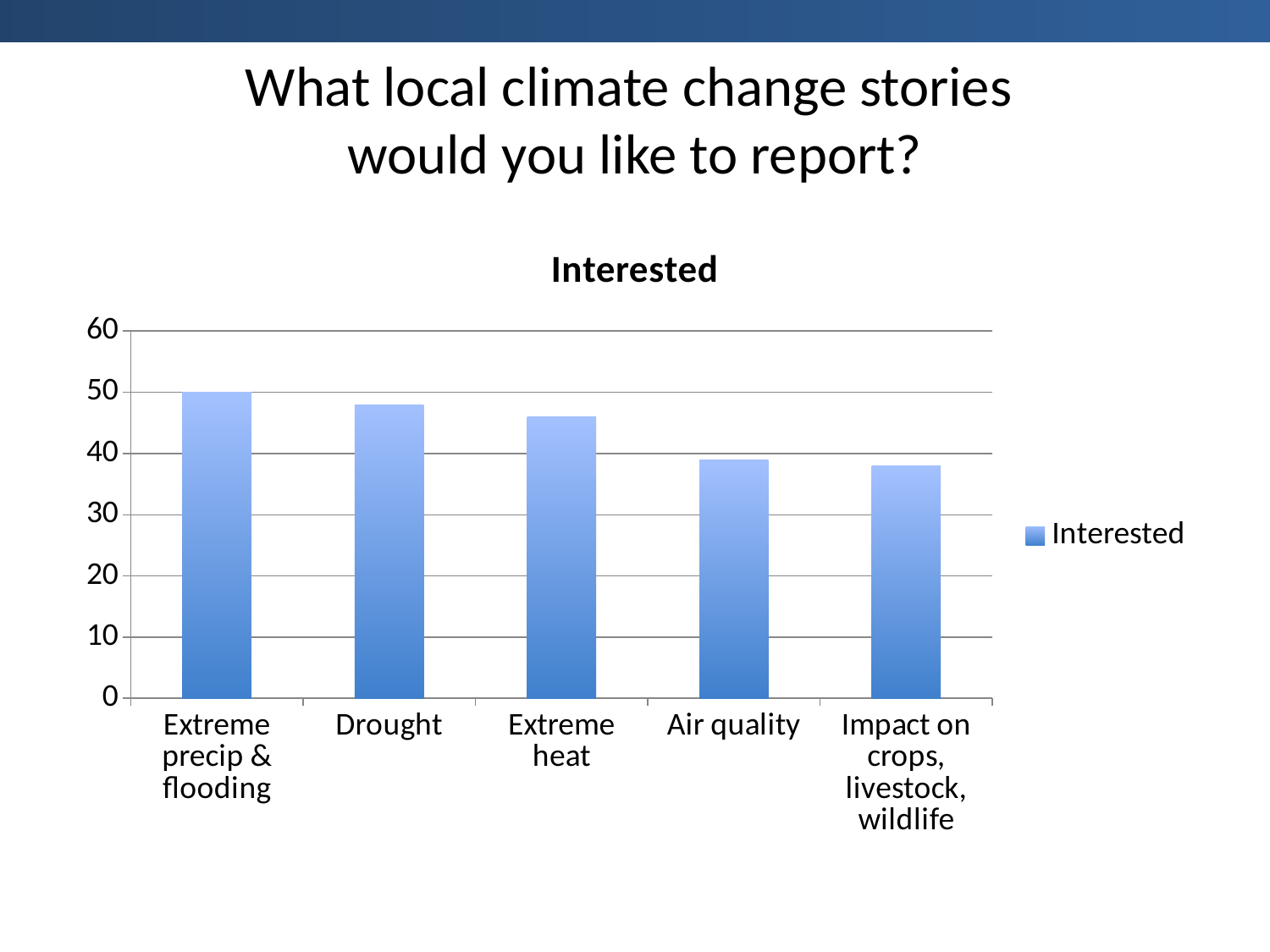
Is the value for Drought greater or less than 40? greater What is the value for Extreme precip & flooding? 50 How many categories are shown on the x axis of the chart? 5 Do the values rise or fall moving from left to right along the x axis? fall Which category has the highest value in the chart? Extreme precip & flooding What type of chart is shown on the slide? bar chart How many series does the chart's legend list? 1 Is the value for Impact on crops, livestock, wildlife greater or less than 40? less Which is larger, the value for Drought or the value for Air quality? Drought What is the title of the chart? Interested Is the value for Extreme heat greater or less than 40? greater